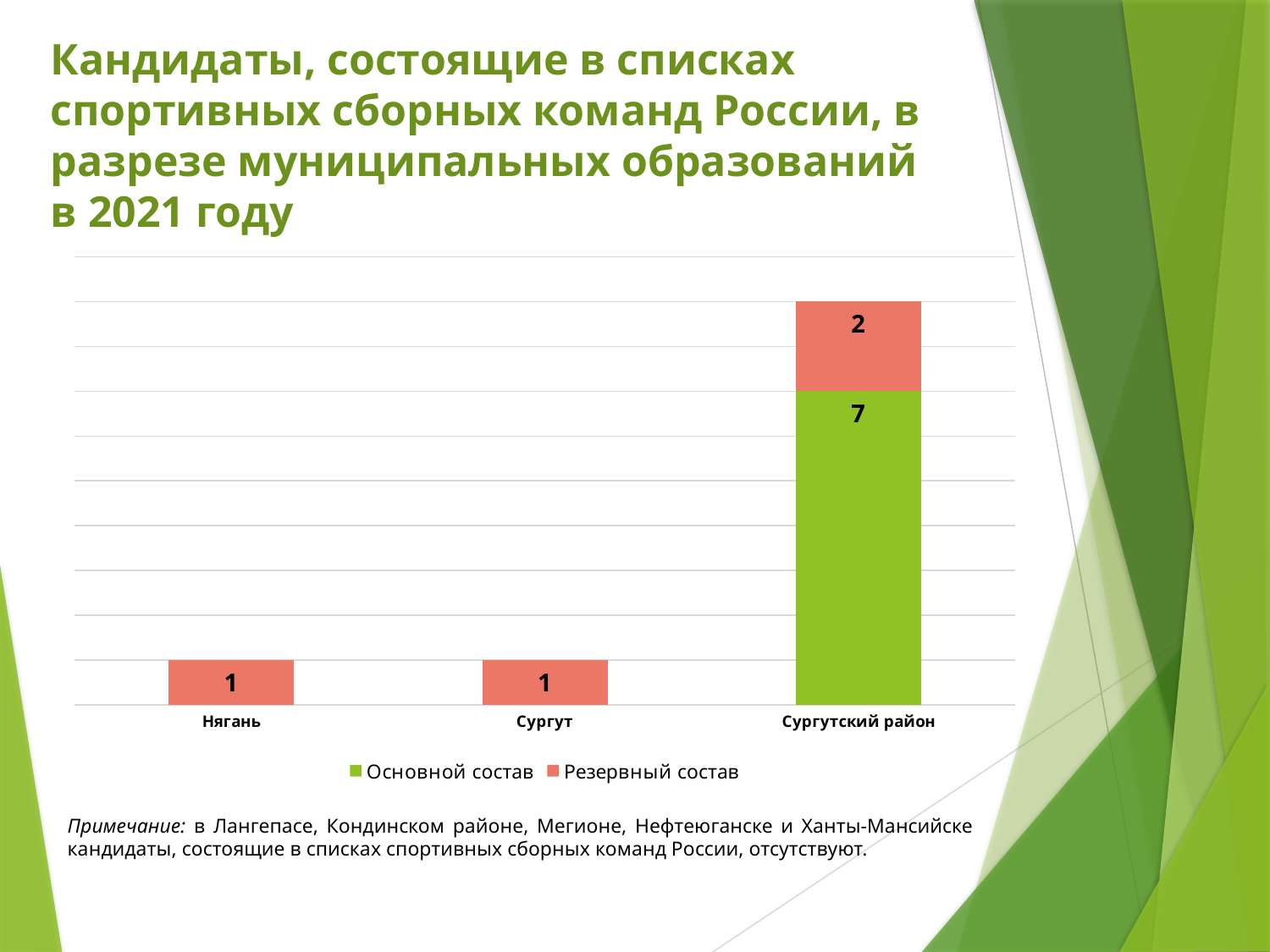
What is the value of Основной состав for Сургутский район? 7 Which is larger for Сургутский район: Основной состав or Резервный состав? Основной состав What is the total of the stacked bar for Сургутский район? 9 How many municipalities (categories) are shown on the x axis of the chart? 3 What is the difference between Основной состав and Резервный состав for Сургутский район? 5 What is the value of Резервный состав for Сургутский район? 2 How many series does the chart legend list? 2 Which colour represents Резервный состав in the chart legend? Red (salmon) Which municipality has the highest total bar in the chart? Сургутский район What type of chart is shown on the slide? Stacked bar chart What is the value of Резервный состав for Сургут? 1 What is the value of Резервный состав for Нягань? 1